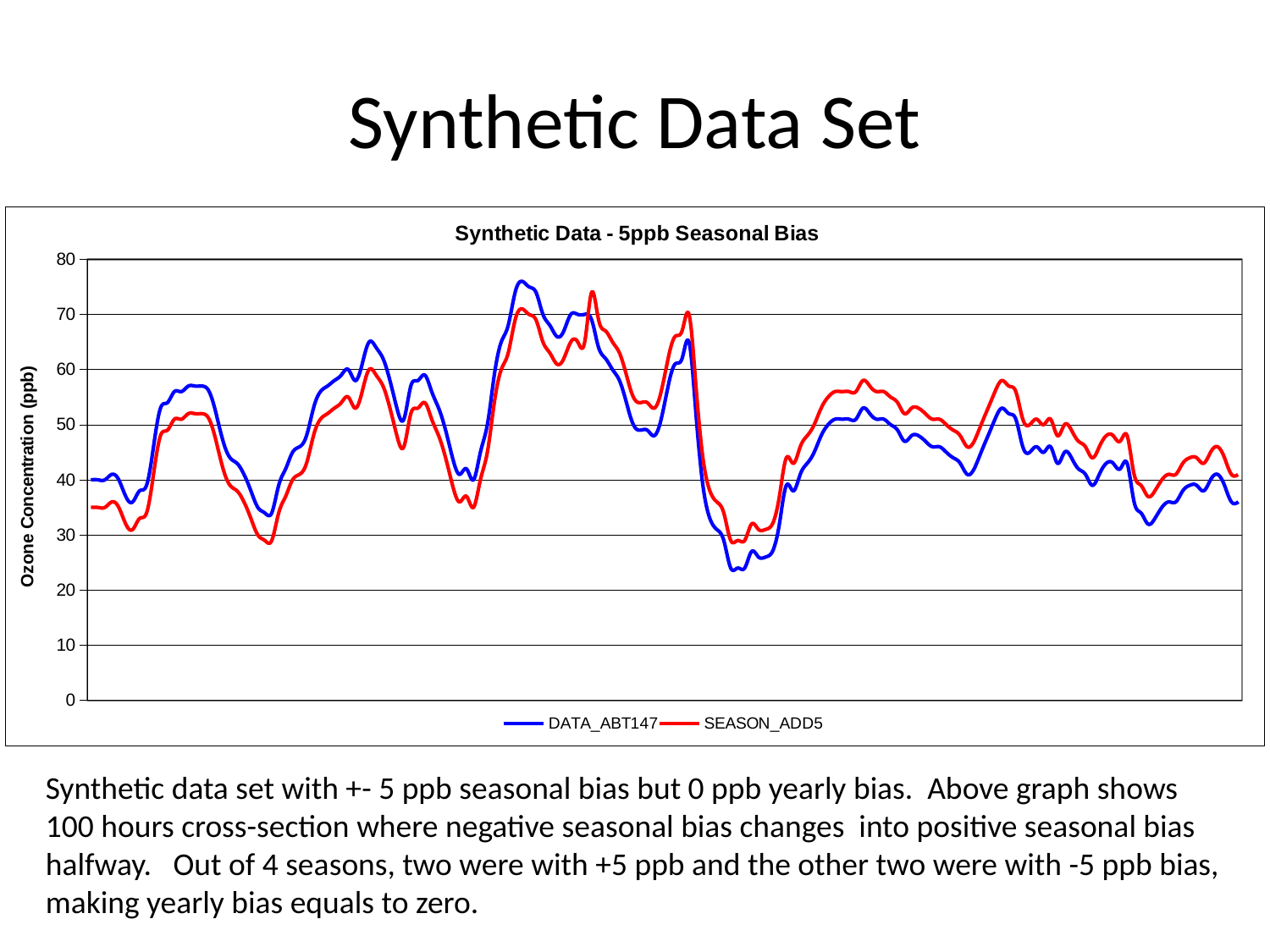
What is the label of the y axis? Ozone Concentration (ppb) Which series reaches the higher peak value, DATA_ABT147 or SEASON_ADD5? DATA_ABT147 Is the highest value reached by the DATA_ABT147 series greater or less than 80? less Is the lowest value reached by the DATA_ABT147 series greater or less than 30? less Is the highest value reached by the DATA_ABT147 series greater or less than 70? greater What is the title of the chart? Synthetic Data - 5ppb Seasonal Bias Which series reaches the lower minimum value, DATA_ABT147 or SEASON_ADD5? DATA_ABT147 How many series does the legend list? 2 What kind of chart is shown on the slide? line chart